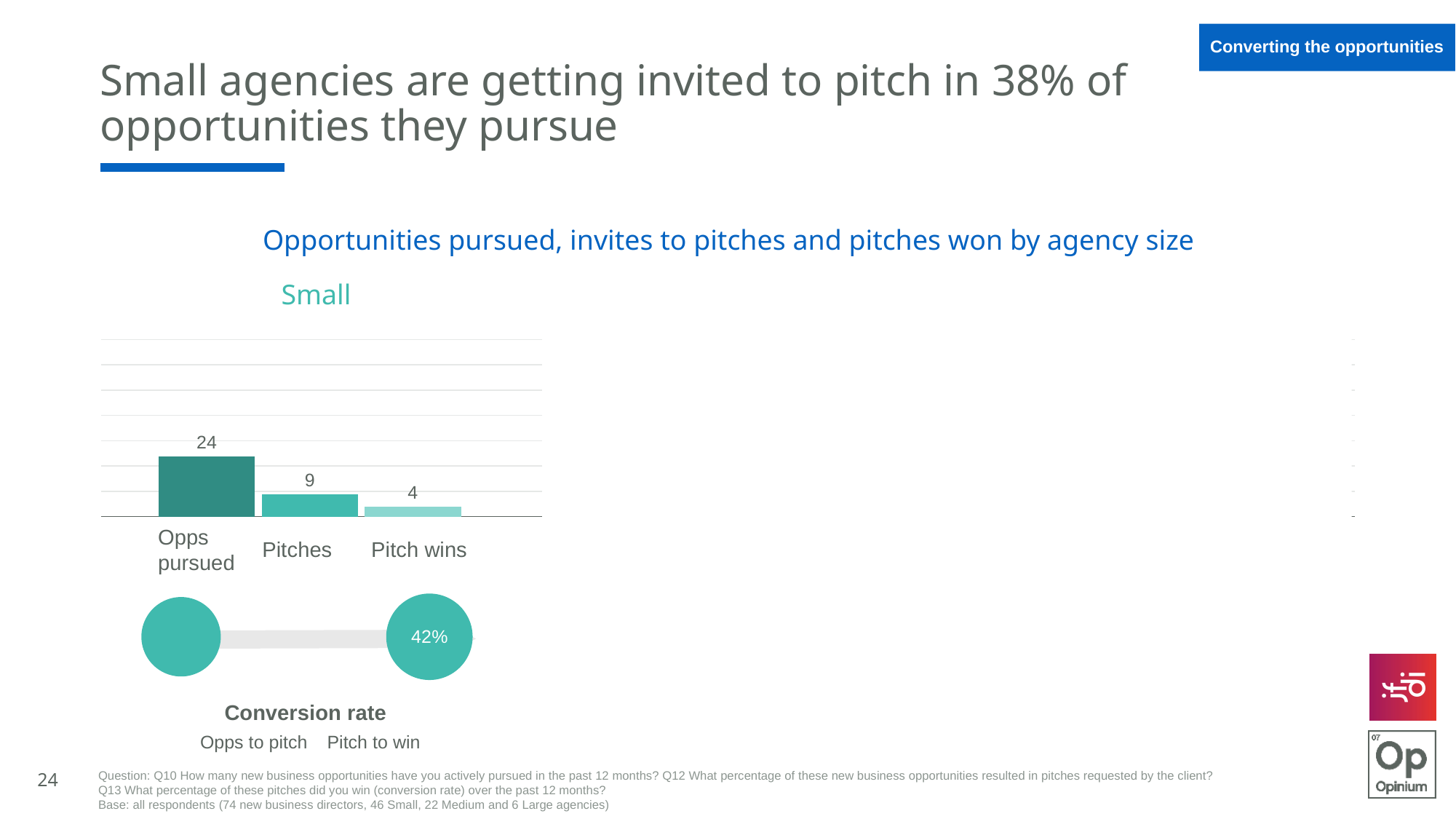
What is the Pitch to win conversion rate shown for Small agencies? 42% Which category has the highest value in the Small agencies bar chart? Opps pursued What kind of chart is used to show opportunities pursued, pitches and pitch wins for Small agencies? Bar chart Which is larger in the Small agencies bar chart, Pitches or Pitch wins? Pitches What is the value for Pitch wins in the Small agencies bar chart? 4 How many categories are shown in the Small agencies bar chart? 3 What is the difference between Pitches and Pitch wins in the Small agencies bar chart? 5 What is the value for Opps pursued in the Small agencies bar chart? 24 What is the difference between Opps pursued and Pitches in the Small agencies bar chart? 15 What is the value for Pitches in the Small agencies bar chart? 9 Do the values rise or fall from Opps pursued to Pitch wins in the Small agencies bar chart? Fall Which category has the lowest value in the Small agencies bar chart? Pitch wins